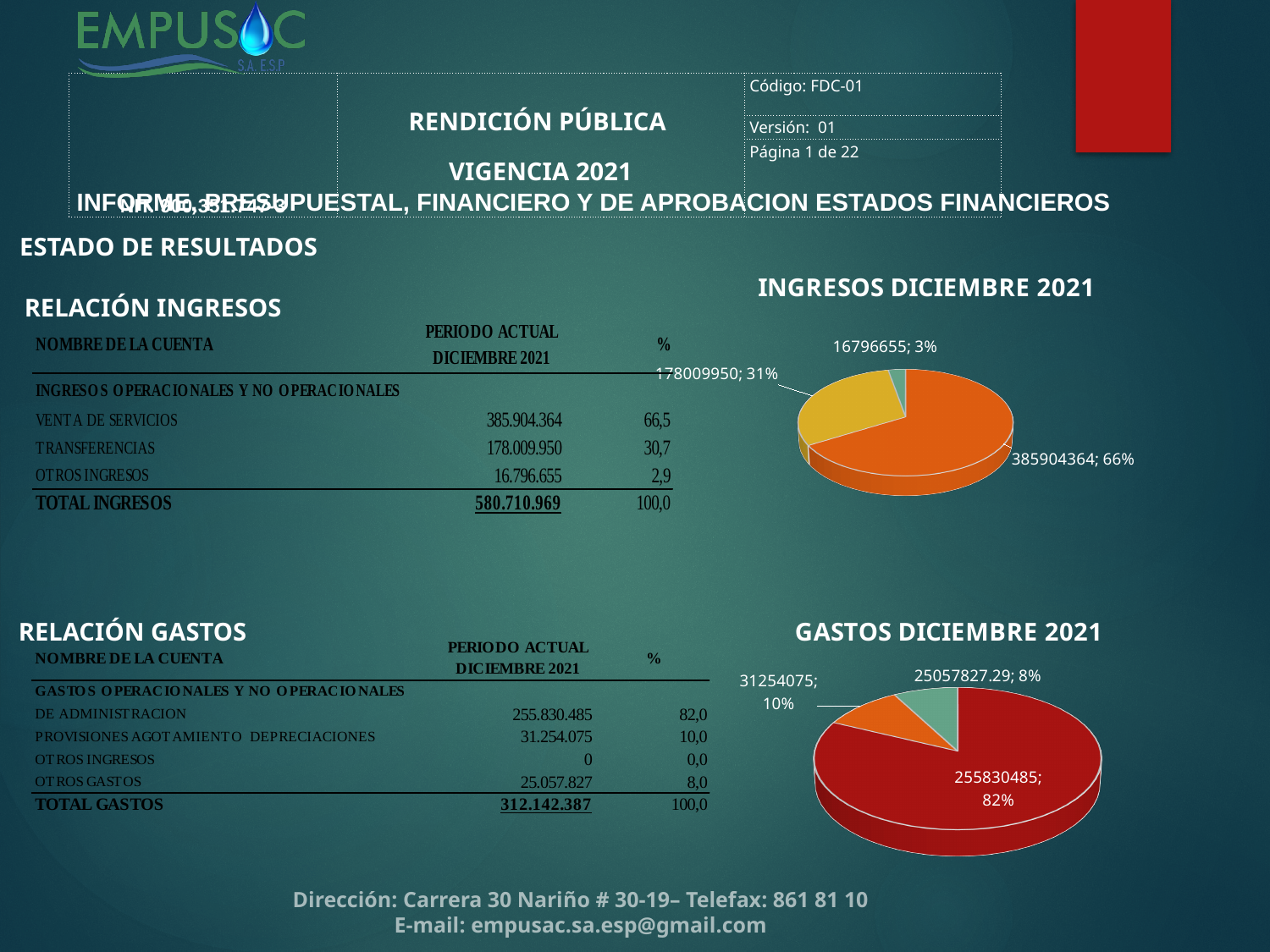
What is the title of the pie chart in the lower right of the slide? GASTOS DICIEMBRE 2021 What kind of chart is the INGRESOS DICIEMBRE 2021 chart? pie chart In the GASTOS DICIEMBRE 2021 chart, what is the value of the slice labelled 8%? 25057827.29 What kind of chart is the GASTOS DICIEMBRE 2021 chart? pie chart In the INGRESOS DICIEMBRE 2021 chart, what is the value of the largest slice? 385904364 How many slices does the GASTOS DICIEMBRE 2021 pie chart have? 3 In the INGRESOS DICIEMBRE 2021 chart, what share of the pie does the slice with value 385904364 represent? 66% In the GASTOS DICIEMBRE 2021 chart, which slice is larger: the one with value 31254075 or the one with value 25057827.29? 31254075 How many slices does the INGRESOS DICIEMBRE 2021 pie chart have? 3 In the INGRESOS DICIEMBRE 2021 chart, what share of the pie does the slice with value 178009950 represent? 31% In the INGRESOS DICIEMBRE 2021 chart, what is the value of the smallest slice? 16796655 In the GASTOS DICIEMBRE 2021 chart, what share of the pie does the slice with value 255830485 represent? 82%